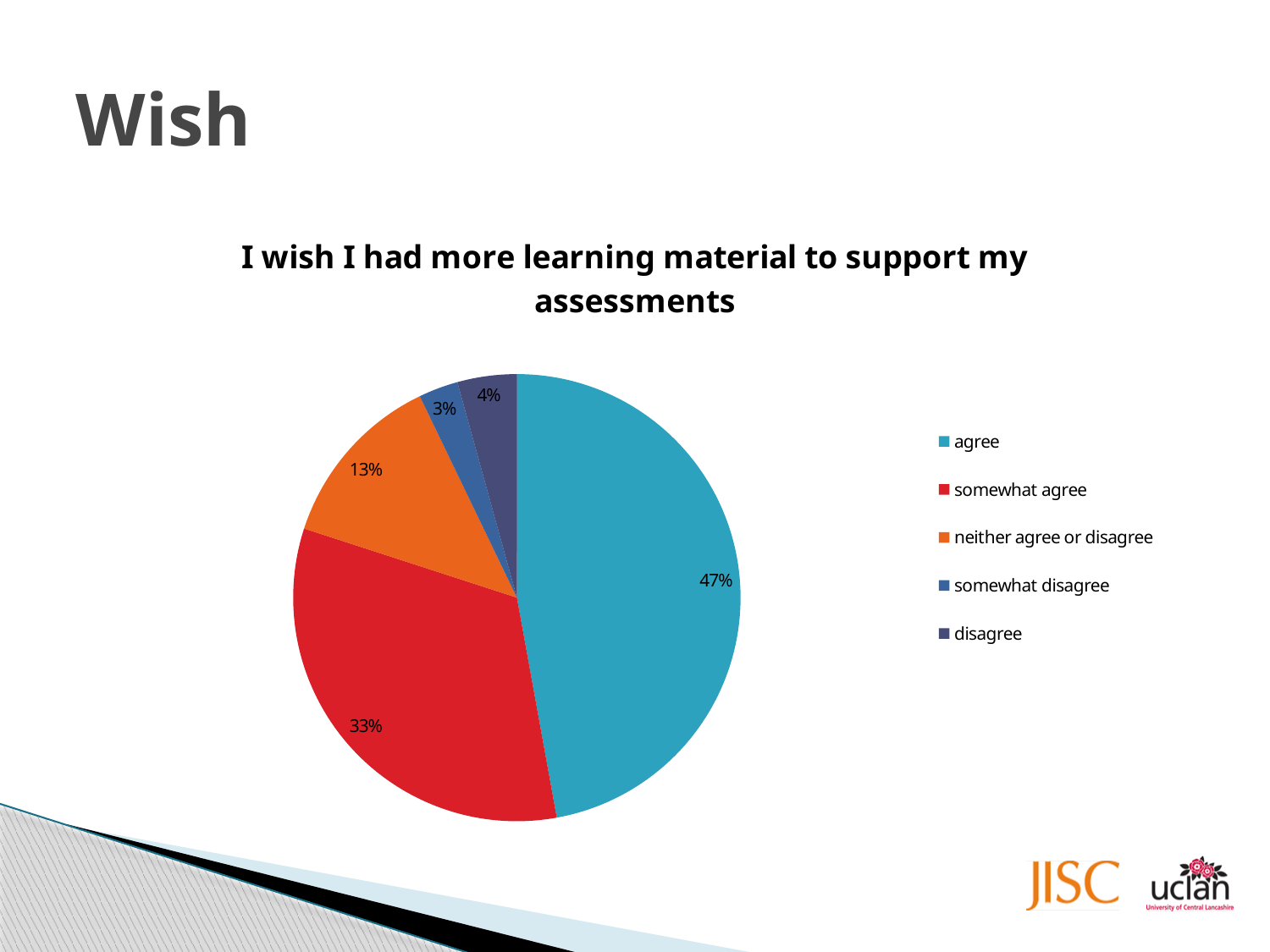
Which is larger, the share for "disagree" or the share for "somewhat disagree"? disagree What percentage of respondents chose "neither agree or disagree"? 13% What type of chart is shown on the slide? pie chart What percentage of respondents chose "somewhat agree"? 33% Which response category has the smallest share of the pie? somewhat disagree What is the difference in percentage points between "agree" and "somewhat agree"? 14 What percentage of respondents chose "somewhat disagree"? 3% What percentage of respondents chose "disagree"? 4% What percentage of respondents chose "agree"? 47% What is the title of the chart? I wish I had more learning material to support my assessments How many response categories are shown in the pie chart? 5 Which response category has the largest share of the pie? agree